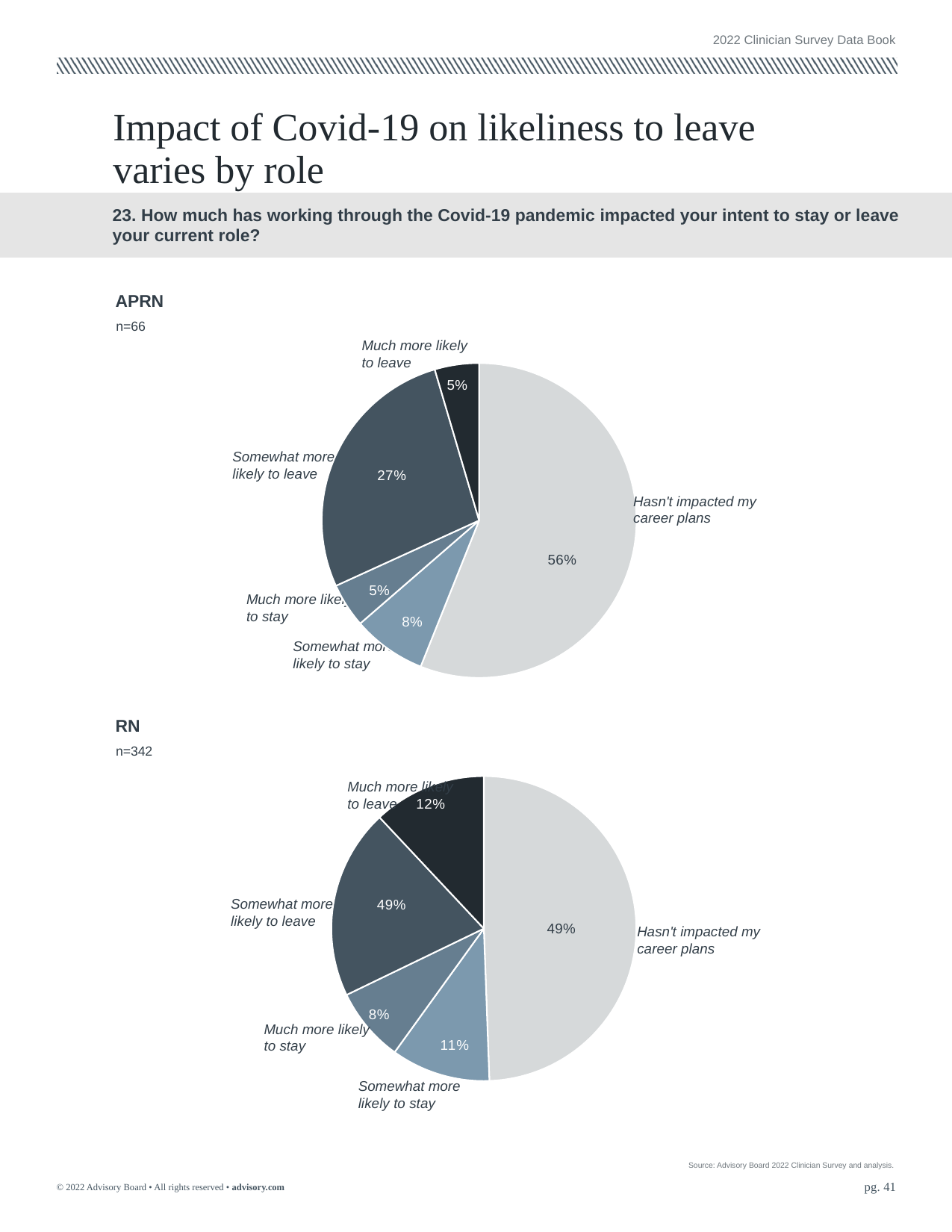
In the APRN pie chart, what is the difference in percentage points between 'Hasn't impacted my career plans' and 'Somewhat more likely to leave'? 29 percentage points In the APRN pie chart, which category has the largest share? Hasn't impacted my career plans In the RN pie chart, what percentage of respondents are much more likely to stay? 8% In the RN pie chart, what percentage of respondents are somewhat more likely to stay? 11% How many slices does the APRN pie chart have? 5 In the APRN pie chart, what percentage of respondents said the pandemic hasn't impacted their career plans? 56% In the APRN pie chart, which is larger: 'Somewhat more likely to stay' or 'Much more likely to stay'? Somewhat more likely to stay In the APRN pie chart, what percentage of respondents are somewhat more likely to leave? 27% What type of chart is used to show the APRN and RN results on this slide? Pie chart What is the sample size (n) shown for the RN chart? n=342 In the RN pie chart, which is larger: 'Somewhat more likely to stay' or 'Much more likely to stay'? Somewhat more likely to stay In the RN pie chart, what percentage of respondents are much more likely to leave? 12%